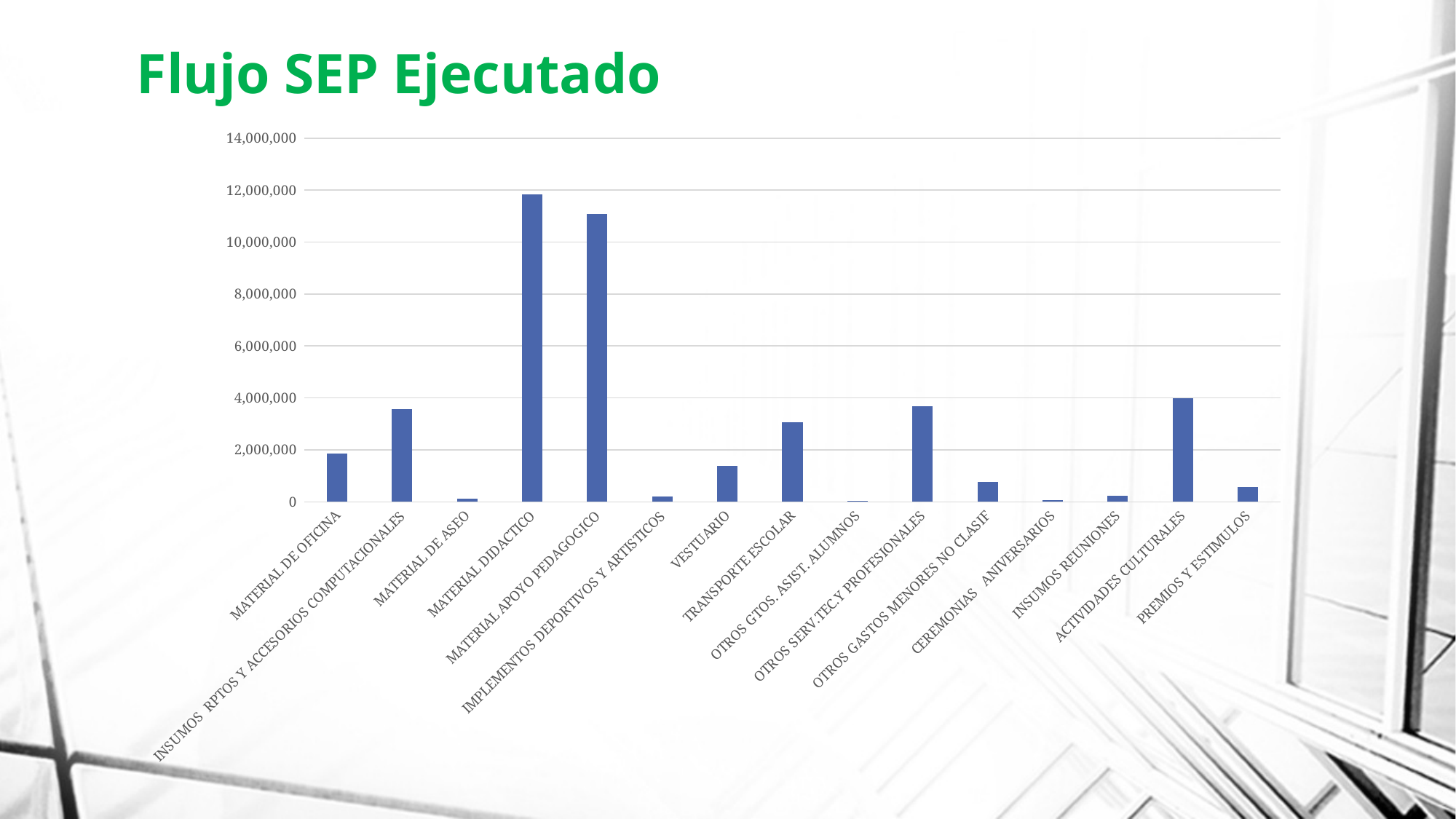
Which is larger, the value for MATERIAL DIDACTICO or the value for MATERIAL APOYO PEDAGOGICO? MATERIAL DIDACTICO What colour are the bars in the chart? blue Which is larger, the value for ACTIVIDADES CULTURALES or the value for TRANSPORTE ESCOLAR? ACTIVIDADES CULTURALES Is the value for VESTUARIO greater or less than 2,000,000? less What kind of chart is shown on the slide? bar chart Is the value for TRANSPORTE ESCOLAR greater or less than 2,000,000? greater How many categories are plotted on the x axis of the chart? 15 Is the value for MATERIAL DIDACTICO greater or less than 10,000,000? greater What is the title of the slide containing the chart? Flujo SEP Ejecutado Which category has the highest value in the chart? MATERIAL DIDACTICO